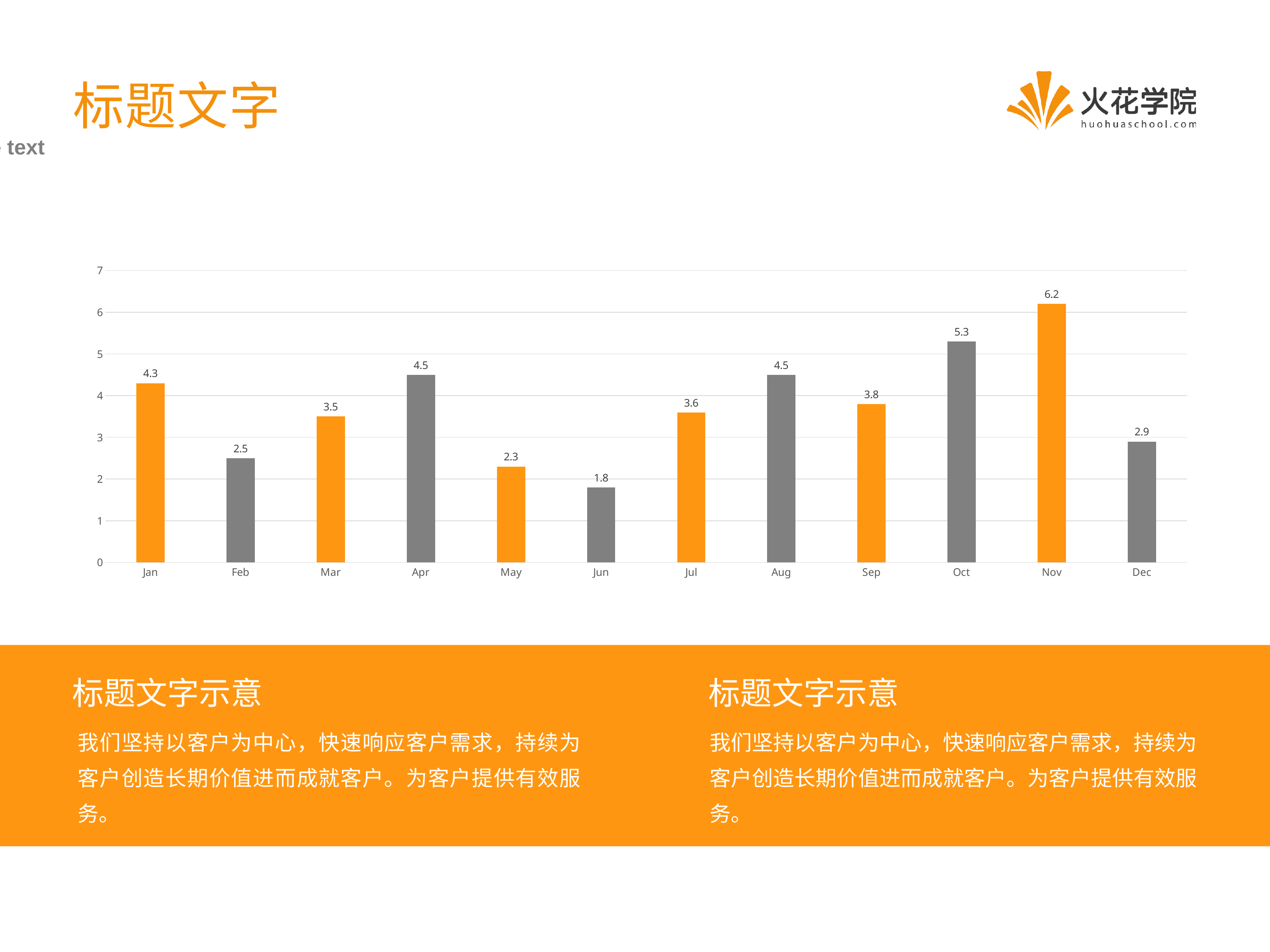
Which month has the highest value? Nov What kind of chart is shown on the slide? bar chart Which is larger, the value for Sep or the value for Dec? Sep What colour is the bar for Apr? grey Which month has the lowest value? Jun What is the value for Nov? 6.2 What is the difference between the values for Nov and Oct? 0.9 What is the value for Jan? 4.3 How many months are shown on the x axis? 12 Is the value for Oct greater or less than 5? greater What is the difference between the values for Jan and Feb? 1.8 What is the value for Jun? 1.8